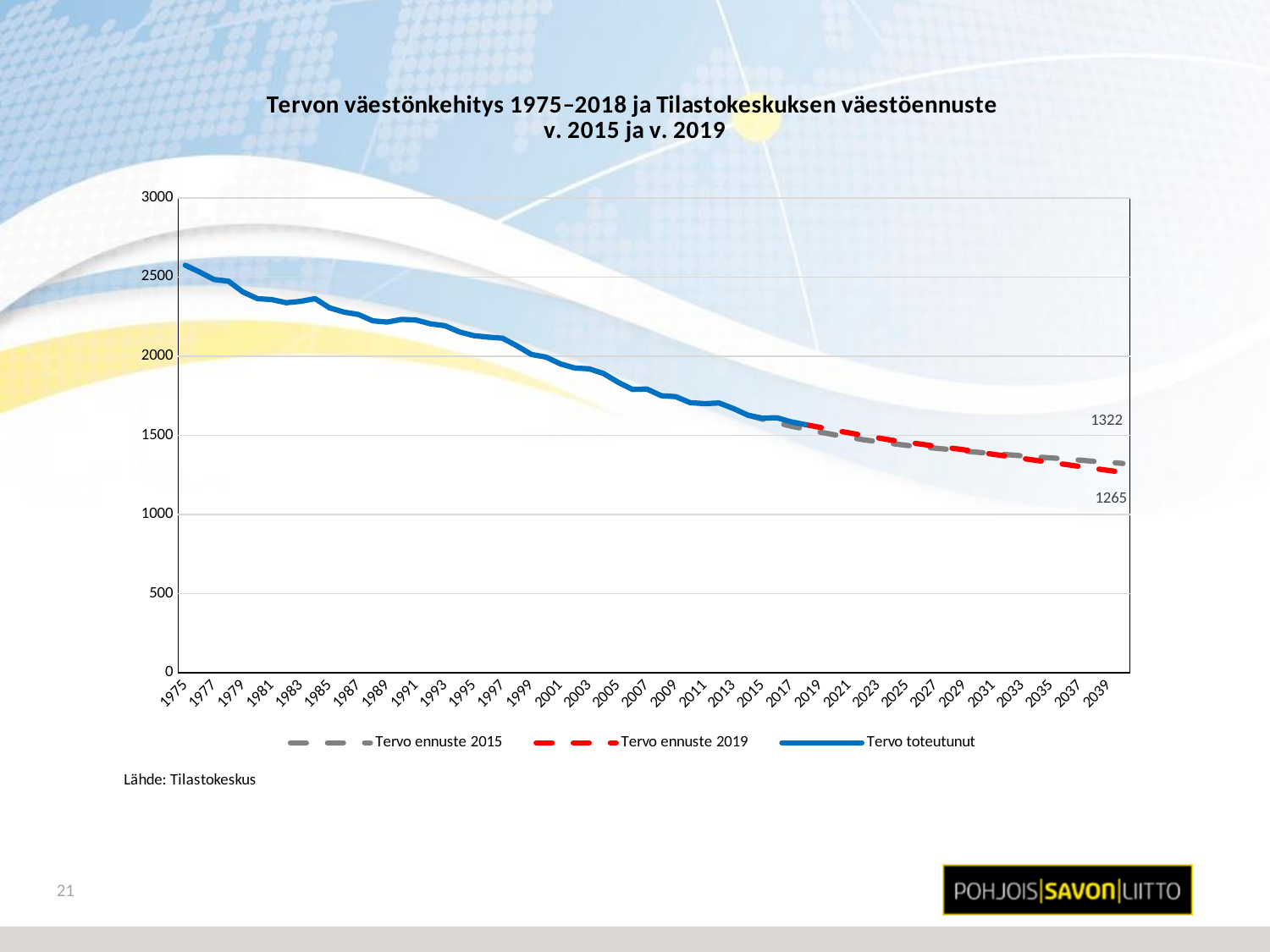
What is the difference between the labelled end values of the Tervo ennuste 2015 and Tervo ennuste 2019 series? 57 Does the Tervo toteutunut series rise or fall from 1975 to 2018? fall What is the final labelled value of the Tervo ennuste 2015 series? 1322 What source is cited below the chart? Tilastokeskus Is the value of Tervo toteutunut in 2015 greater or less than 2000? less What is the final labelled value of the Tervo ennuste 2019 series? 1265 How many series does the legend list? 3 Is the value of Tervo toteutunut in 1975 greater or less than 2500? greater What colour is the Tervo toteutunut line? blue Which forecast series ends at a higher value, Tervo ennuste 2015 or Tervo ennuste 2019? Tervo ennuste 2015 What kind of chart is shown on the slide? line chart In which year does the Tervo toteutunut series reach its highest value? 1975